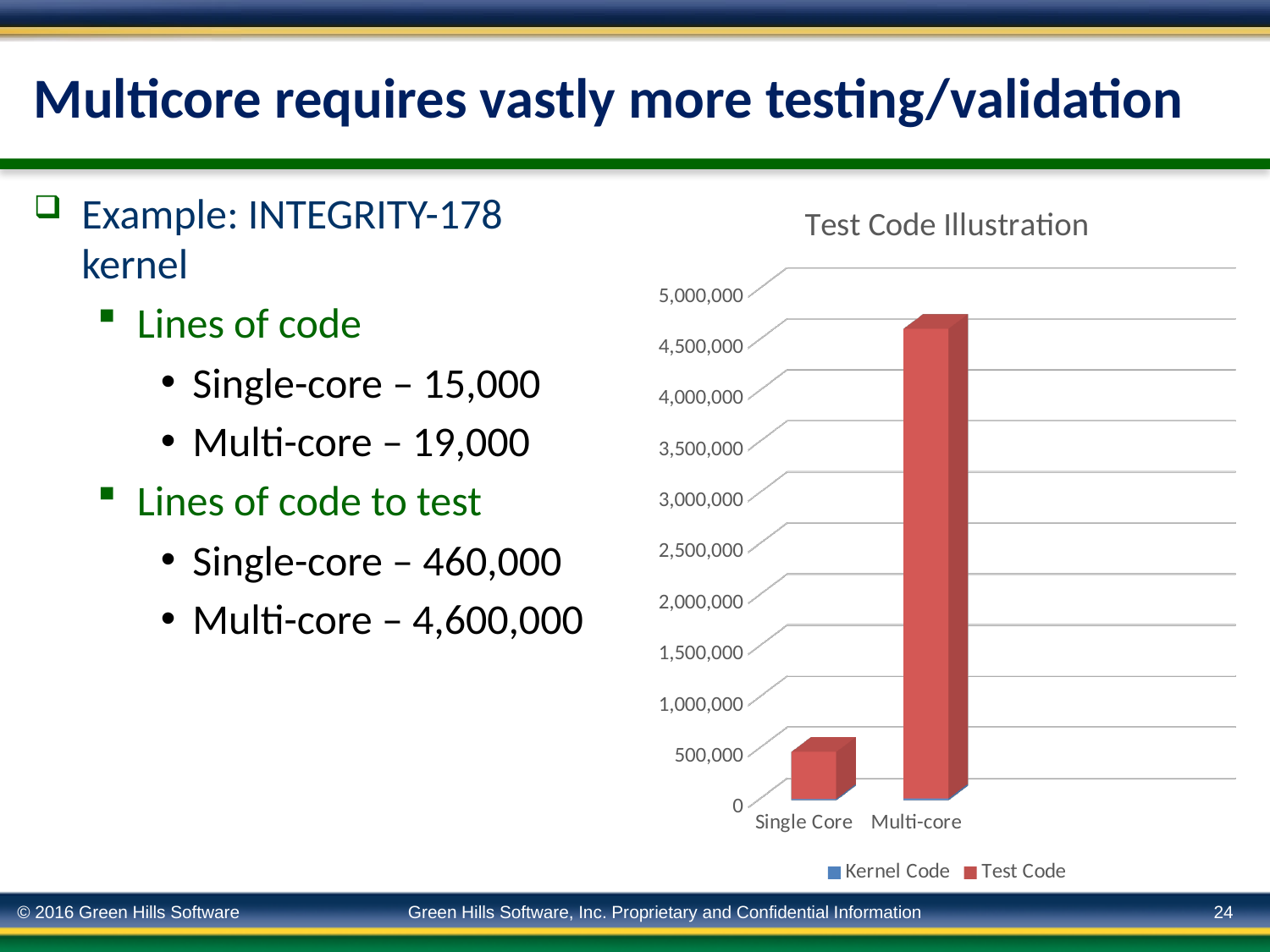
How many series does the chart legend list? 2 Which category has the shortest bar in the chart? Single Core How many categories are shown on the x axis of the chart? 2 Do the bar heights rise or fall going from Single Core to Multi-core? rise What is the title of the chart on the slide? Test Code Illustration What kind of chart is shown on the slide? bar chart Is the bar for Multi-core taller or shorter than the bar for Single Core? taller Is the total bar height for Single Core greater or less than 1,000,000? less What is the highest value labelled on the chart's vertical axis? 5,000,000 Is the total bar height for Multi-core greater or less than 4,000,000? greater Which category has the tallest bar in the chart? Multi-core Which series are listed in the chart legend? Kernel Code and Test Code